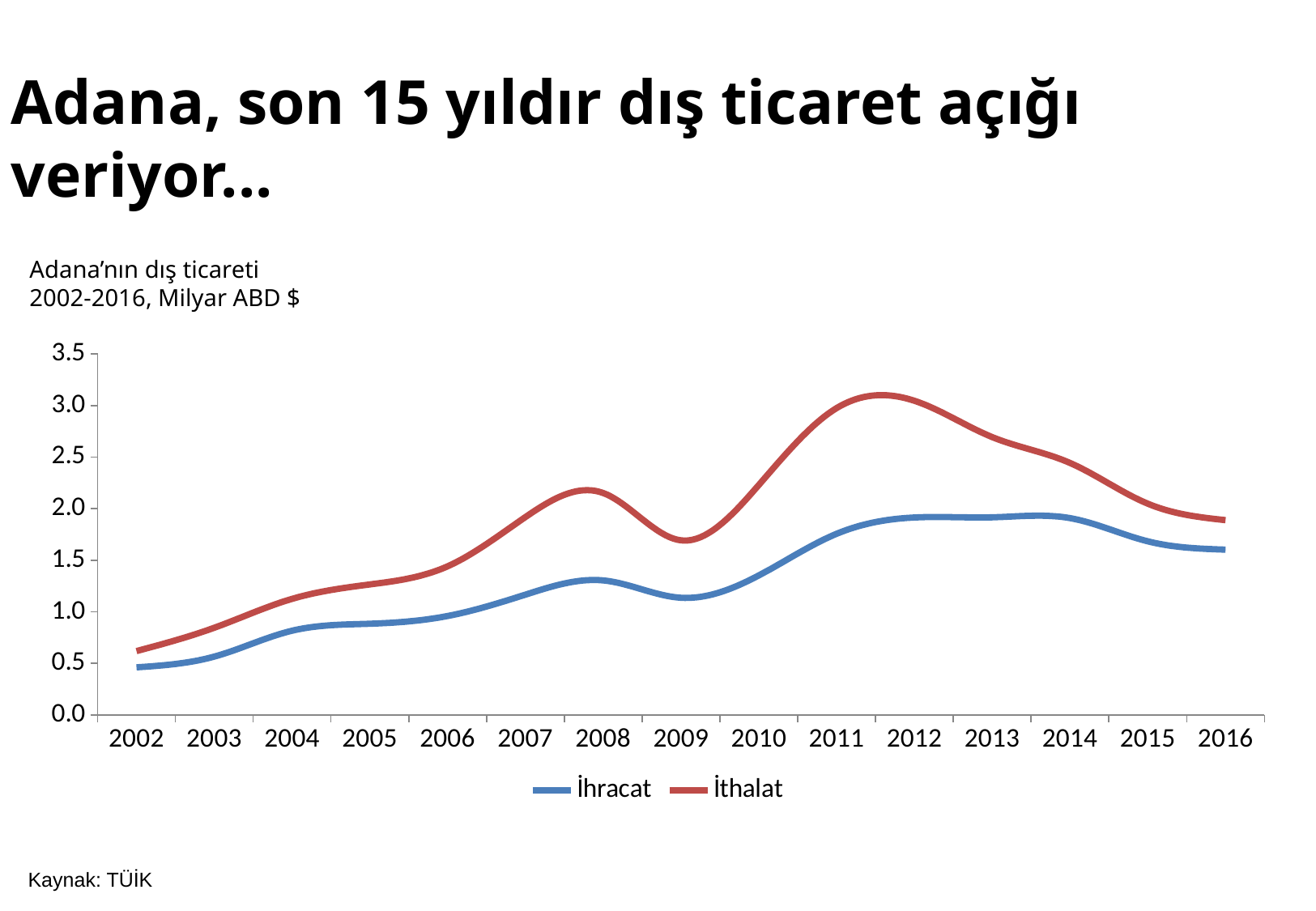
What kind of chart is shown on the slide? line chart Is the value for İthalat in 2012 greater or less than 2.5? greater Is the value for İhracat in 2008 greater or less than 1.0? greater Which colour is used for the İthalat line? red In which year is İthalat at its highest? 2012 In which year is İhracat at its lowest? 2002 In which year is İthalat at its lowest? 2002 In 2012, which is larger, İhracat or İthalat? İthalat How many years are shown on the x axis? 15 How many series does the legend list? 2 Is the value for İthalat in 2009 greater or less than 2.0? less Does İthalat rise or fall from 2012 to 2016? fall